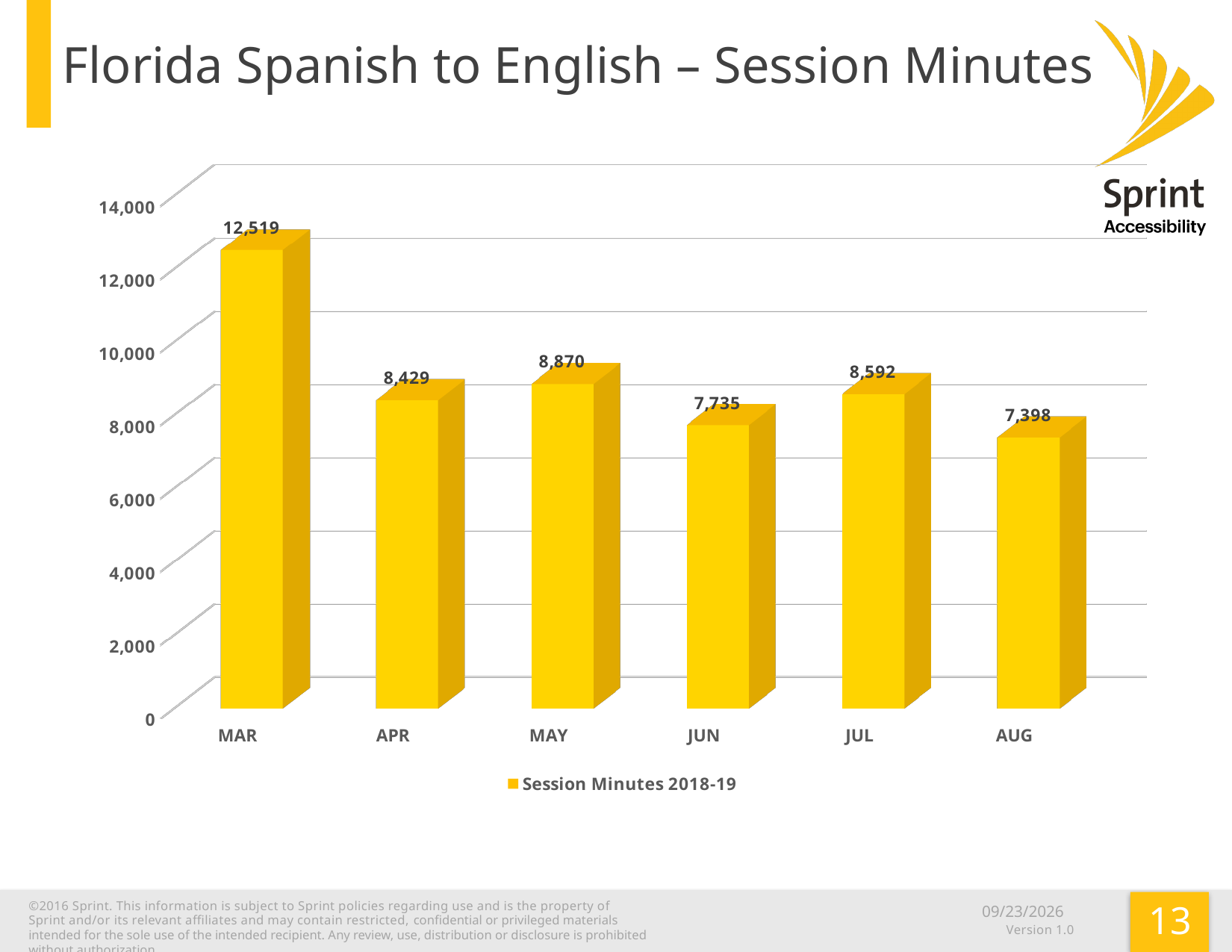
Which is larger, the value for MAY or the value for JUL? MAY What is the value for MAR? 12,519 Which month has the highest session minutes? MAR Which month has the lowest session minutes? AUG How many months are shown on the x axis? 6 What is the value for JUN? 7,735 Is the value for JUL greater or less than 8,000? greater What is the difference between the values for MAY and JUN? 1,135 What is the legend entry for the series shown? Session Minutes 2018-19 What is the difference between the values for MAR and APR? 4,090 What kind of chart is shown on the slide? bar chart What is the value for AUG? 7,398